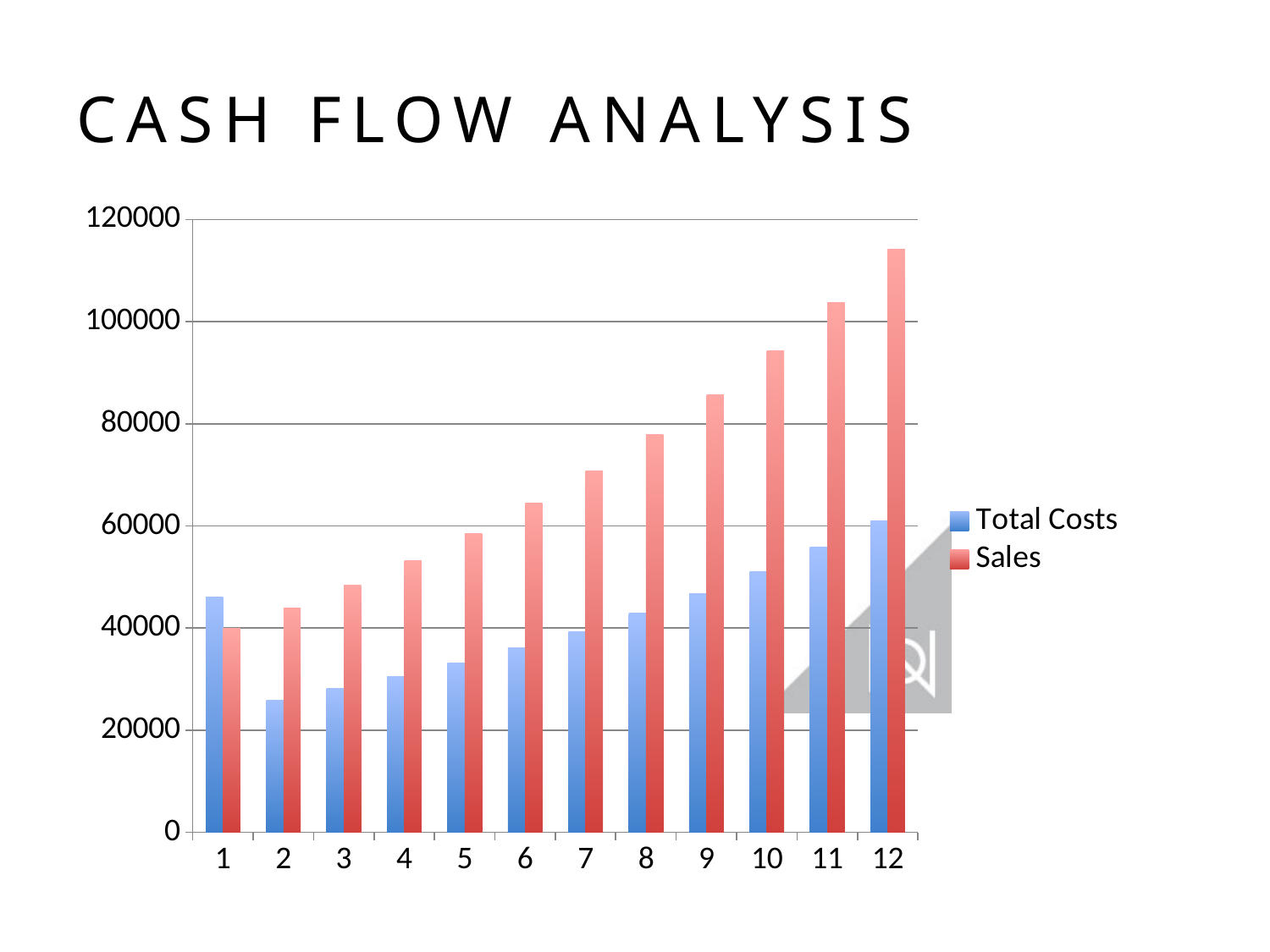
How many series does the legend list? 2 Do Sales values rise or fall from period 1 to period 12? rise In which period is Sales highest? 12 In period 1, which is larger, Total Costs or Sales? Total Costs Is the Sales value for period 9 greater or less than 100000? less What kind of chart is shown on the slide? bar chart In period 12, which is larger, Total Costs or Sales? Sales Is the Total Costs value for period 10 greater or less than 40000? greater Is the Sales value for period 12 greater or less than 100000? greater What is the title of the slide? CASH FLOW ANALYSIS How many periods are shown along the x axis? 12 In which period is Total Costs lowest? 2